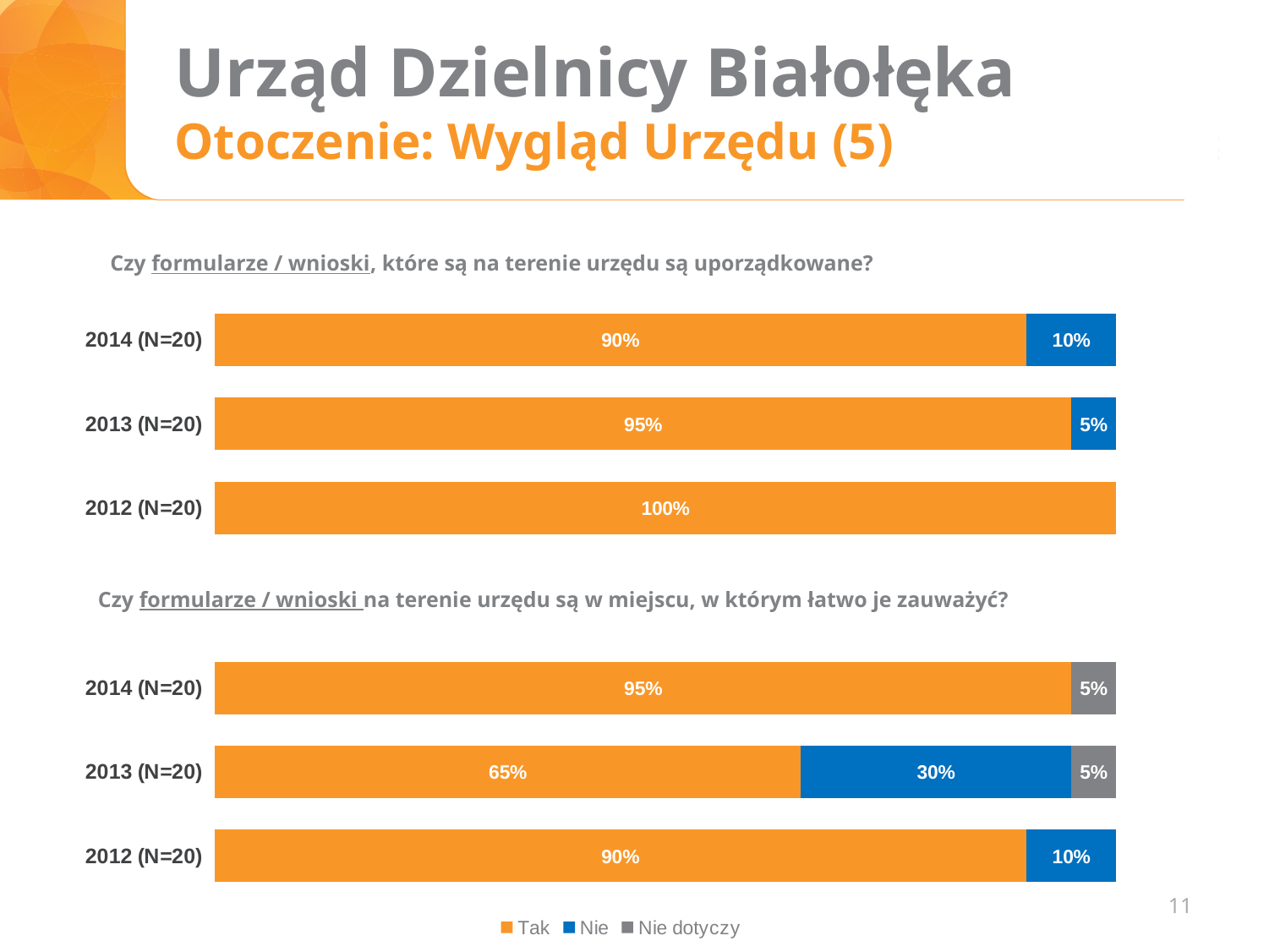
In the bottom chart ("Czy formularze / wnioski na terenie urzędu są w miejscu, w którym łatwo je zauważyć?"), which year has the lowest value for "Tak"? 2013 (N=20) What type of chart is the bottom chart ("Czy formularze / wnioski na terenie urzędu są w miejscu, w którym łatwo je zauważyć?")? Stacked bar chart In the bottom chart ("Czy formularze / wnioski na terenie urzędu są w miejscu, w którym łatwo je zauważyć?"), what is the value for "Nie" in 2013 (N=20)? 30% In the top chart ("Czy formularze / wnioski, które są na terenie urzędu są uporządkowane?"), what is the value for "Tak" in 2014 (N=20)? 90% In the top chart ("Czy formularze / wnioski, które są na terenie urzędu są uporządkowane?"), what is the value for "Nie" in 2013 (N=20)? 5% In the top chart ("Czy formularze / wnioski, które są na terenie urzędu są uporządkowane?"), which year has the highest value for "Tak"? 2012 (N=20) How many series does the legend at the bottom of the slide list? 3 In the top chart ("Czy formularze / wnioski, które są na terenie urzędu są uporządkowane?"), what is the difference between the "Tak" values for 2012 (N=20) and 2014 (N=20)? 10% In the bottom chart ("Czy formularze / wnioski na terenie urzędu są w miejscu, w którym łatwo je zauważyć?"), what is the difference between the "Tak" values for 2014 (N=20) and 2013 (N=20)? 30% In the bottom chart ("Czy formularze / wnioski na terenie urzędu są w miejscu, w którym łatwo je zauważyć?"), is the "Tak" value for 2014 (N=20) larger or smaller than for 2012 (N=20)? larger In the bottom chart ("Czy formularze / wnioski na terenie urzędu są w miejscu, w którym łatwo je zauważyć?"), what is the value for "Nie dotyczy" in 2014 (N=20)? 5% How many years (categories) are shown in the top chart ("Czy formularze / wnioski, które są na terenie urzędu są uporządkowane?")? 3